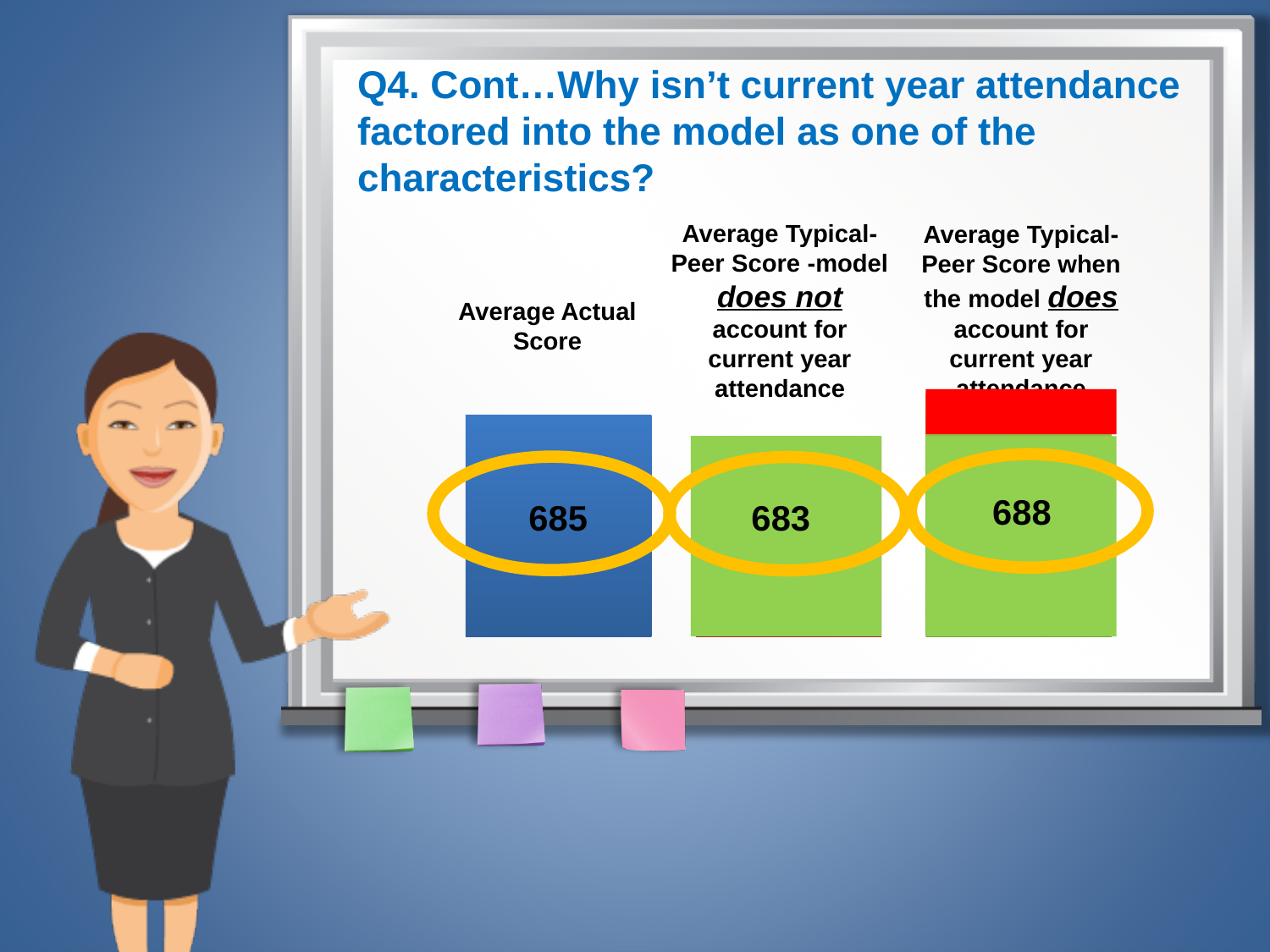
What is the difference between the Average Typical-Peer Score when the model does account for current year attendance and the Average Actual Score? 3 What is the Average Actual Score shown on the chart? 685 What kind of chart is shown on the slide? Bar chart Which category has the lowest score on the chart? Average Typical-Peer Score - model does not account for current year attendance How many bars are shown on the chart? 3 Which is larger: the Average Actual Score or the Average Typical-Peer Score when the model does not account for current year attendance? Average Actual Score What is the difference between the two Average Typical-Peer Scores (model does vs. does not account for current year attendance)? 5 What is the Average Typical-Peer Score when the model does account for current year attendance? 688 What is the difference between the Average Actual Score and the Average Typical-Peer Score when the model does not account for current year attendance? 2 Which category has the highest score on the chart? Average Typical-Peer Score when the model does account for current year attendance What colour is the bar for the Average Actual Score? Blue What is the Average Typical-Peer Score when the model does not account for current year attendance? 683